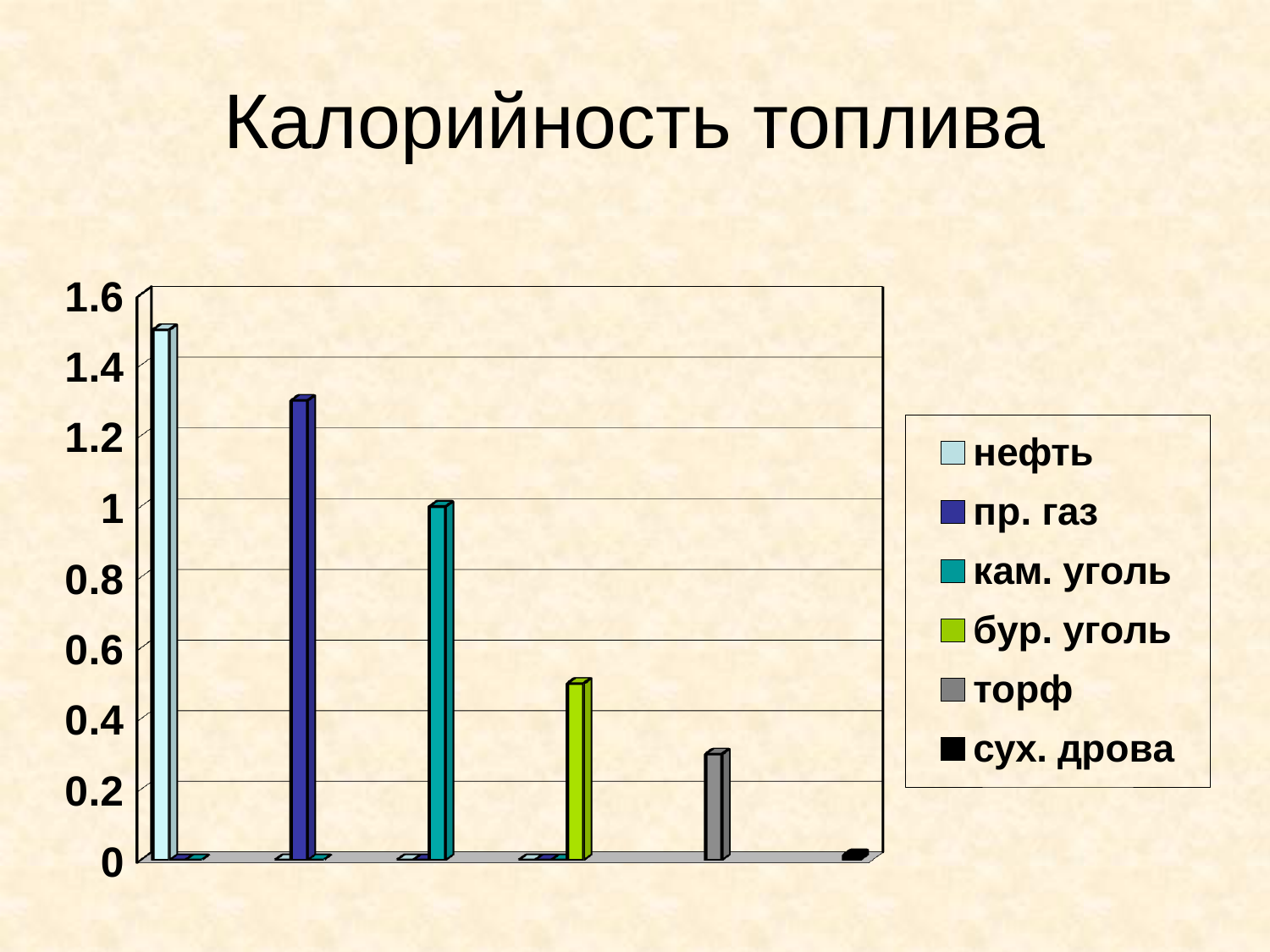
Is the value for бур. уголь greater or less than 0.6? less Is the value for пр. газ greater or less than 1.2? greater What kind of chart is shown on the slide? bar chart What is the title of the chart? Калорийность топлива Is the value for торф greater or less than 0.4? less Which fuel has the highest value in the chart? нефть Which is larger, the value for бур. уголь or the value for торф? бур. уголь Which is larger, the value for нефть or the value for пр. газ? нефть Which fuel has the lowest value in the chart? сух. дрова How many series does the legend list? 6 Do the bar values rise or fall from left to right across the chart? fall